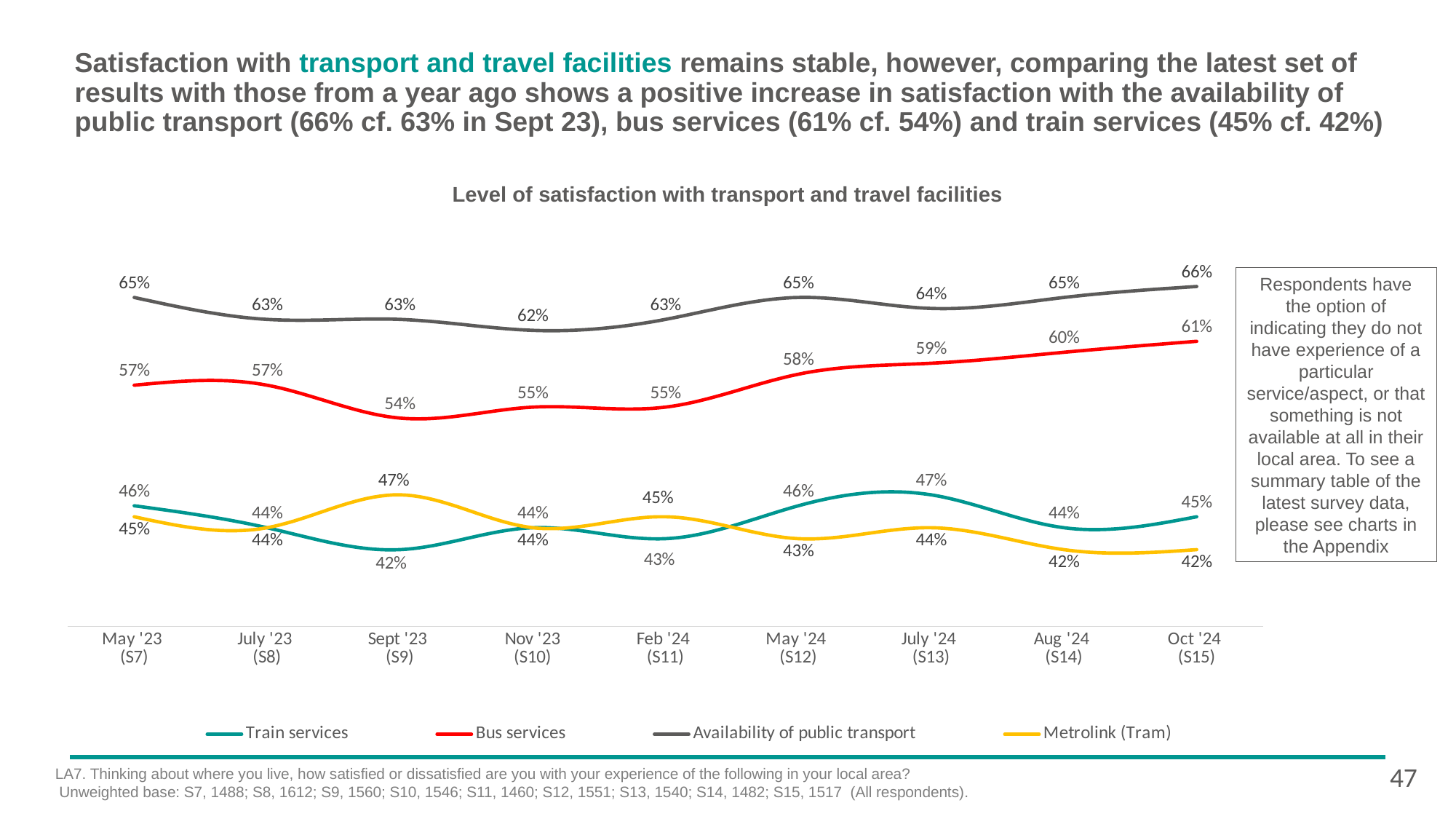
What type of chart is shown on the slide? Line chart In which survey wave is Bus services satisfaction lowest? Sept '23 (S9) Does Bus services satisfaction rise or fall between Feb '24 (S11) and Oct '24 (S15)? Rise How many survey waves are plotted along the x axis? 9 How many series does the legend list? 4 What is the title of the chart? Level of satisfaction with transport and travel facilities What is the satisfaction value for Availability of public transport in Nov '23 (S10)? 62% What is the satisfaction value for Bus services in Oct '24 (S15)? 61% In May '24 (S12), which is higher: Train services or Metrolink (Tram)? Train services What is the difference between Bus services satisfaction in Oct '24 (S15) and Sept '23 (S9)? 7 percentage points What is the satisfaction value for Metrolink (Tram) in Sept '23 (S9)? 47% In which survey wave is Availability of public transport satisfaction highest? Oct '24 (S15)